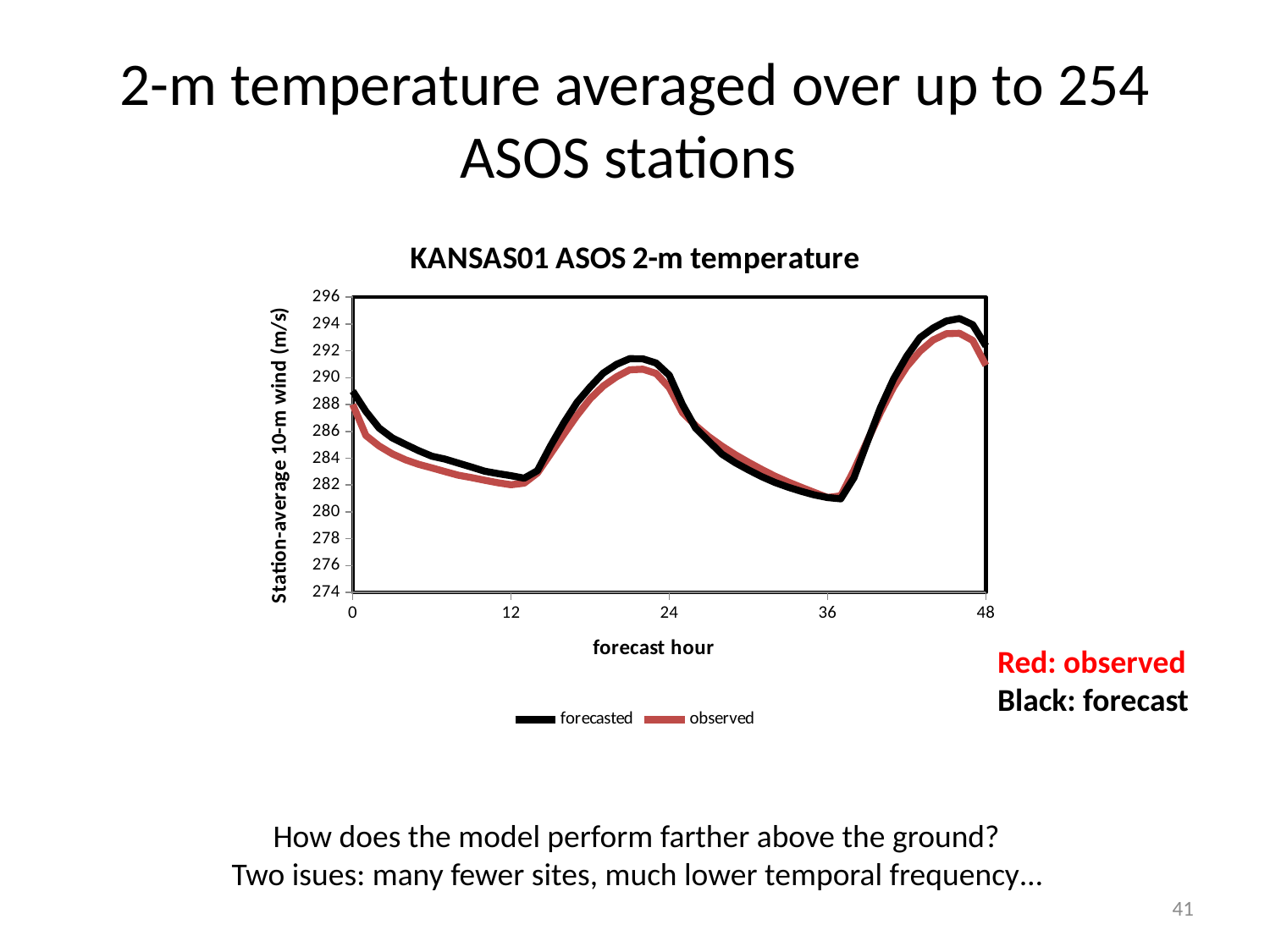
What are the two series named in the legend? forecasted and observed At forecast hour 48, which series has the higher value, forecasted or observed? forecasted Is the observed value at forecast hour 12 greater or less than 284? less Between forecast hour 0 and forecast hour 12, does the forecasted series rise or fall? fall How many series does the legend list? 2 What kind of chart is shown on the slide? line chart Is the forecasted value at forecast hour 0 greater or less than 288? greater Which series reaches the higher peak value between forecast hours 36 and 48? forecasted What is the title of the chart? KANSAS01 ASOS 2-m temperature At forecast hour 0, which series has the higher value, forecasted or observed? forecasted Is the forecasted value at forecast hour 48 greater or less than 290? greater